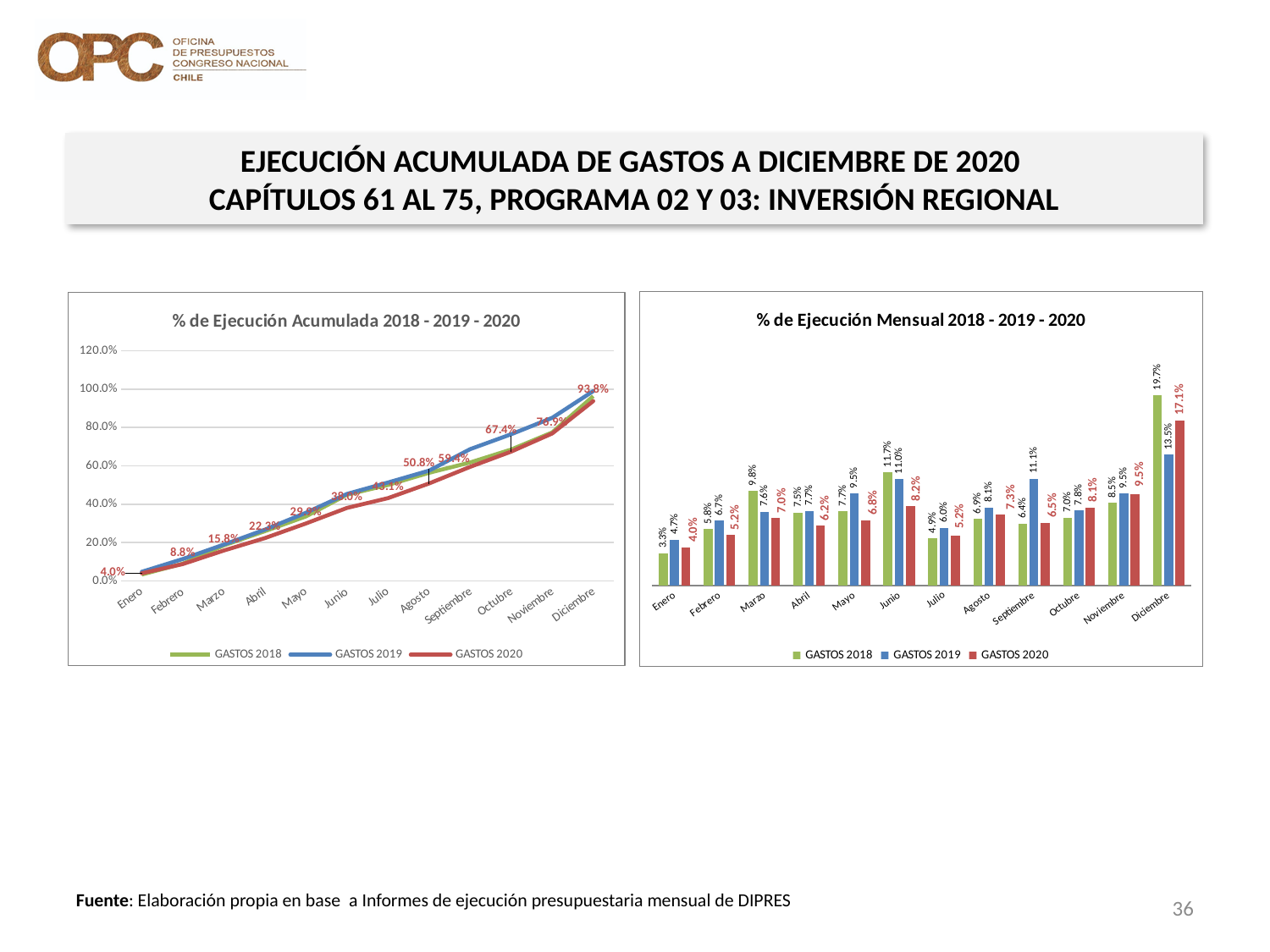
In the chart titled '% de Ejecución Acumulada 2018 - 2019 - 2020', do the values for GASTOS 2020 rise or fall from Enero to Diciembre? Rise What kind of chart is the one titled '% de Ejecución Mensual 2018 - 2019 - 2020'? Bar chart In the chart titled '% de Ejecución Mensual 2018 - 2019 - 2020', how many series does the legend list? 3 In the chart titled '% de Ejecución Mensual 2018 - 2019 - 2020', which month has the highest value for GASTOS 2018? Diciembre In the chart titled '% de Ejecución Acumulada 2018 - 2019 - 2020', what is the value for GASTOS 2020 in Octubre? 67.4% In the chart titled '% de Ejecución Mensual 2018 - 2019 - 2020', which month has the lowest value for GASTOS 2020? Enero In the chart titled '% de Ejecución Mensual 2018 - 2019 - 2020', what is the difference between GASTOS 2018 and GASTOS 2019 in Diciembre? 6.2% In the chart titled '% de Ejecución Mensual 2018 - 2019 - 2020', what is the value for GASTOS 2018 in Junio? 11.7% In the chart titled '% de Ejecución Mensual 2018 - 2019 - 2020', which is larger in Marzo: GASTOS 2018 or GASTOS 2020? GASTOS 2018 In the chart titled '% de Ejecución Mensual 2018 - 2019 - 2020', what is the value for GASTOS 2019 in Septiembre? 11.1% In the chart titled '% de Ejecución Mensual 2018 - 2019 - 2020', what is the value for GASTOS 2020 in Diciembre? 17.1% In the chart titled '% de Ejecución Acumulada 2018 - 2019 - 2020', what is the value for GASTOS 2020 in Diciembre? 93.8%